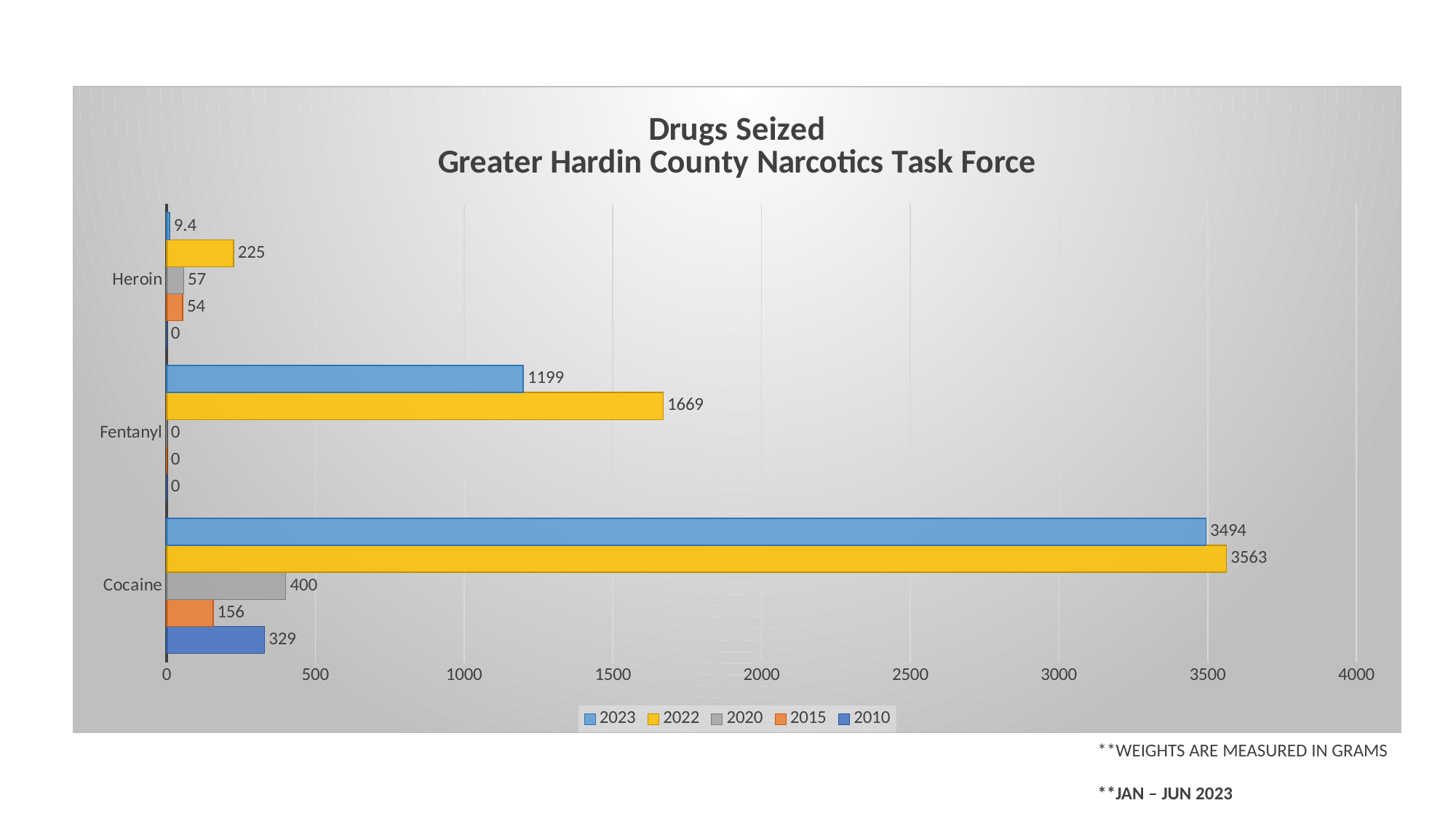
What was the amount of heroin seized in 2015? 54 What was the amount of cocaine seized in 2010? 329 What was the amount of fentanyl seized in 2023? 1199 Which is larger: cocaine seized in 2020 or cocaine seized in 2010? 2020 What was the amount of cocaine seized in 2022? 3563 Which year had the lowest amount of heroin seized? 2010 What kind of chart is shown on the slide? Bar chart How many drug categories are shown on the chart? 3 Which drug had the highest amount seized in 2022? Cocaine How many series does the legend list? 5 What is the difference between the fentanyl seized in 2022 and in 2023? 470 What is the title of the chart? Drugs Seized Greater Hardin County Narcotics Task Force